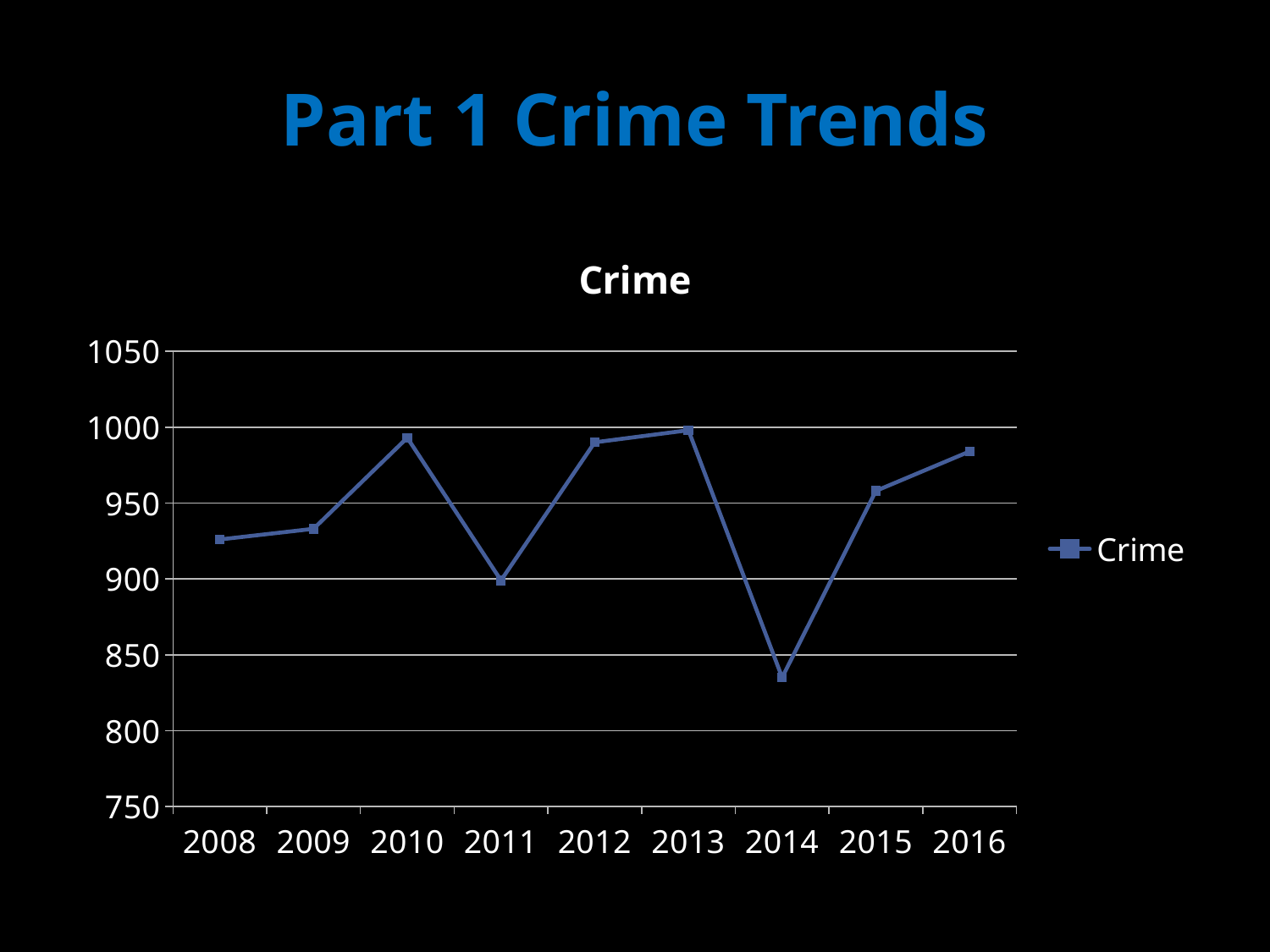
How many years are plotted along the x axis of the Crime chart? 9 Is the value for 2016 greater or less than 950? greater Is the value for 2014 greater or less than 850? less Which year has the larger value, 2014 or 2015? 2015 Is the value for 2011 greater or less than 950? less What is the title of the chart on the slide? Crime Which year has the larger value, 2011 or 2012? 2012 What kind of chart is shown on the slide? Line chart How many series does the legend of the Crime chart list? 1 Which year has the lowest value in the Crime chart? 2014 Does the value rise or fall from 2014 to 2016? rise